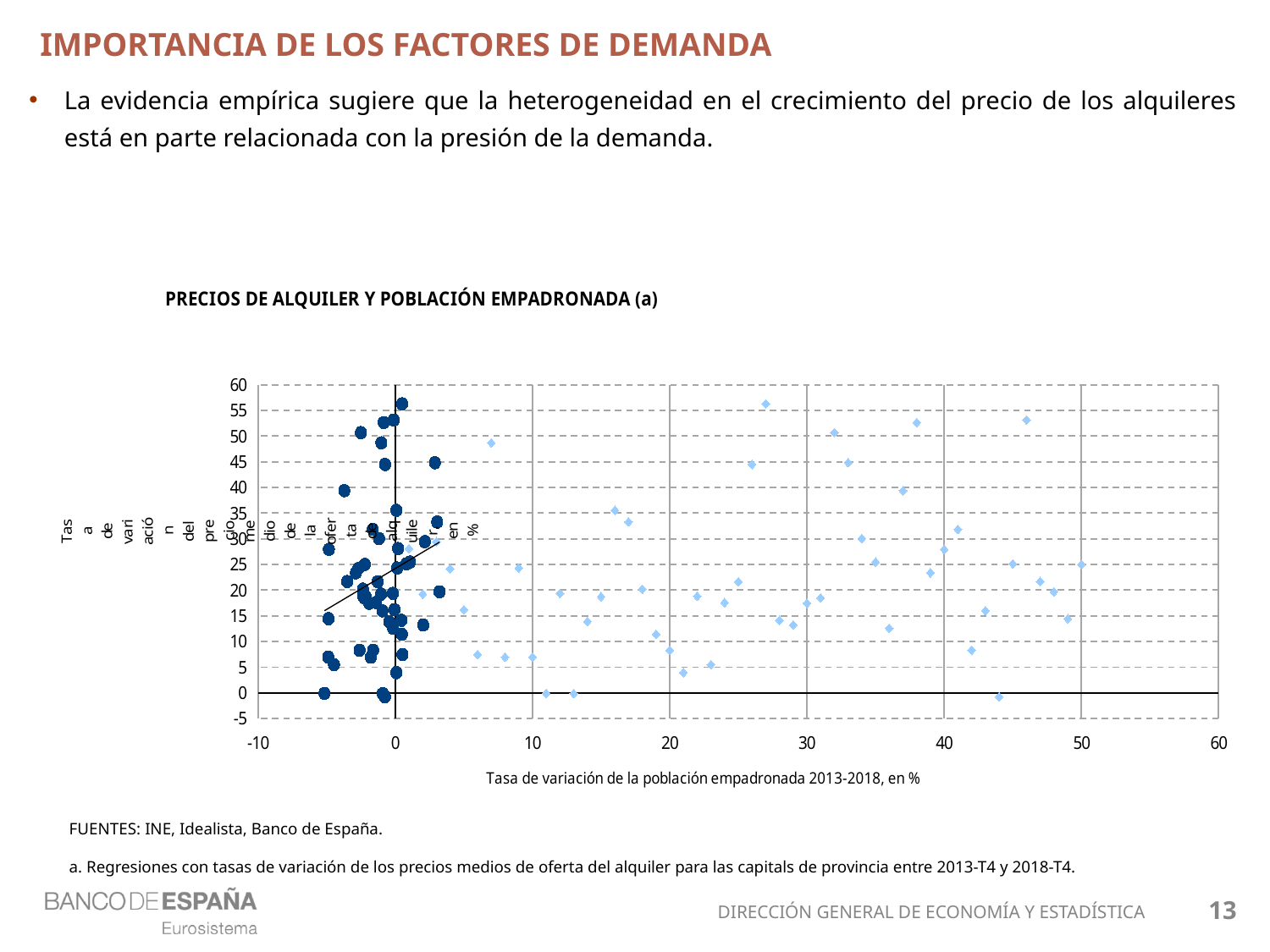
What kind of chart is shown on the slide? scatter chart What is the label of the horizontal axis of the chart? Tasa de variación de la población empadronada 2013-2018, en % Does the fitted line in the chart slope upward or downward as the x-axis value increases? upward What is the title of the chart? PRECIOS DE ALQUILER Y POBLACIÓN EMPADRONADA (a) Overall, do the plotted rental price variation values tend to rise or fall as the population variation rate increases? rise